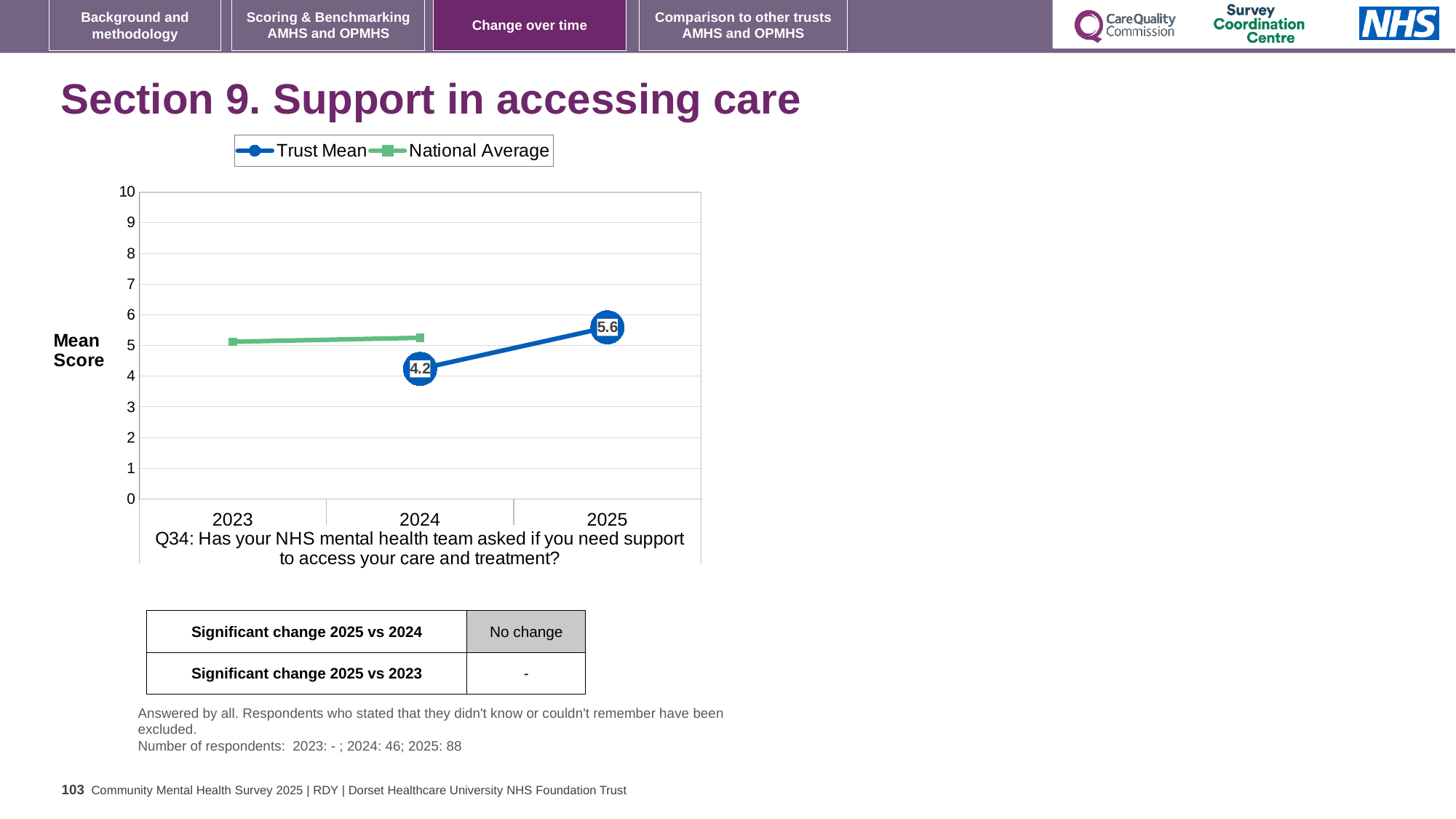
What is the label on the y axis of the chart? Mean Score What is the Trust Mean score for 2025? 5.6 Is the National Average value for 2023 greater or less than 6? less Is the National Average value for 2024 greater or less than 4? greater How many series does the legend list? 2 What is the Trust Mean score for 2024? 4.2 By how much did the Trust Mean score increase from 2024 to 2025? 1.4 Which year has the highest Trust Mean score? 2025 What kind of chart is shown on the slide? line chart Does the Trust Mean rise or fall from 2024 to 2025? rise How many years are shown on the x axis of the chart? 3 In 2024, which is larger: the Trust Mean or the National Average? National Average